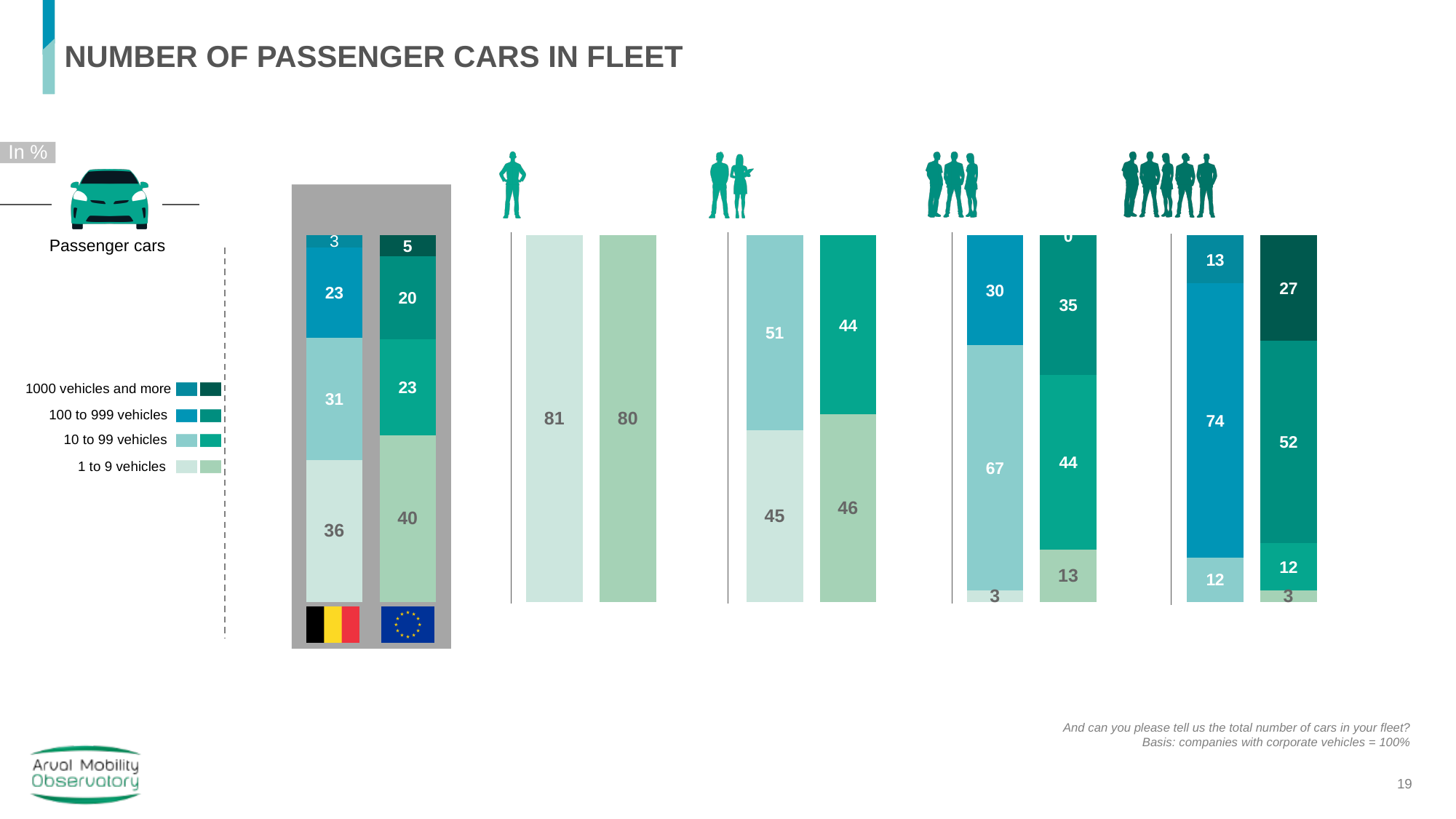
In the Belgium bar (Belgian flag), what is the value for 100 to 999 vehicles? 23 In the Belgium bar (Belgian flag), which fleet-size category has the largest segment? 1 to 9 vehicles In the Europe bar (EU flag), what is the value for 1 to 9 vehicles? 40 What is the difference between the Europe and Belgium values for 1 to 9 vehicles? 4 How many series does the legend list? 4 For 10 to 99 vehicles, which is larger: the Belgium bar or the Europe bar? Belgium In the Europe bar (EU flag), what is the value for 1000 vehicles and more? 5 What kind of chart is shown on the slide? Stacked bar chart In the rightmost pair of bars (under the five-person icon), what is the value of the 100 to 999 vehicles segment in the left (blue) bar? 74 In the pair of bars under the single-person icon, what value is shown on the left (blue-shaded) bar? 81 In the Belgium bar (Belgian flag), what is the value for 1 to 9 vehicles? 36 In what unit are the values on the slide expressed? In %